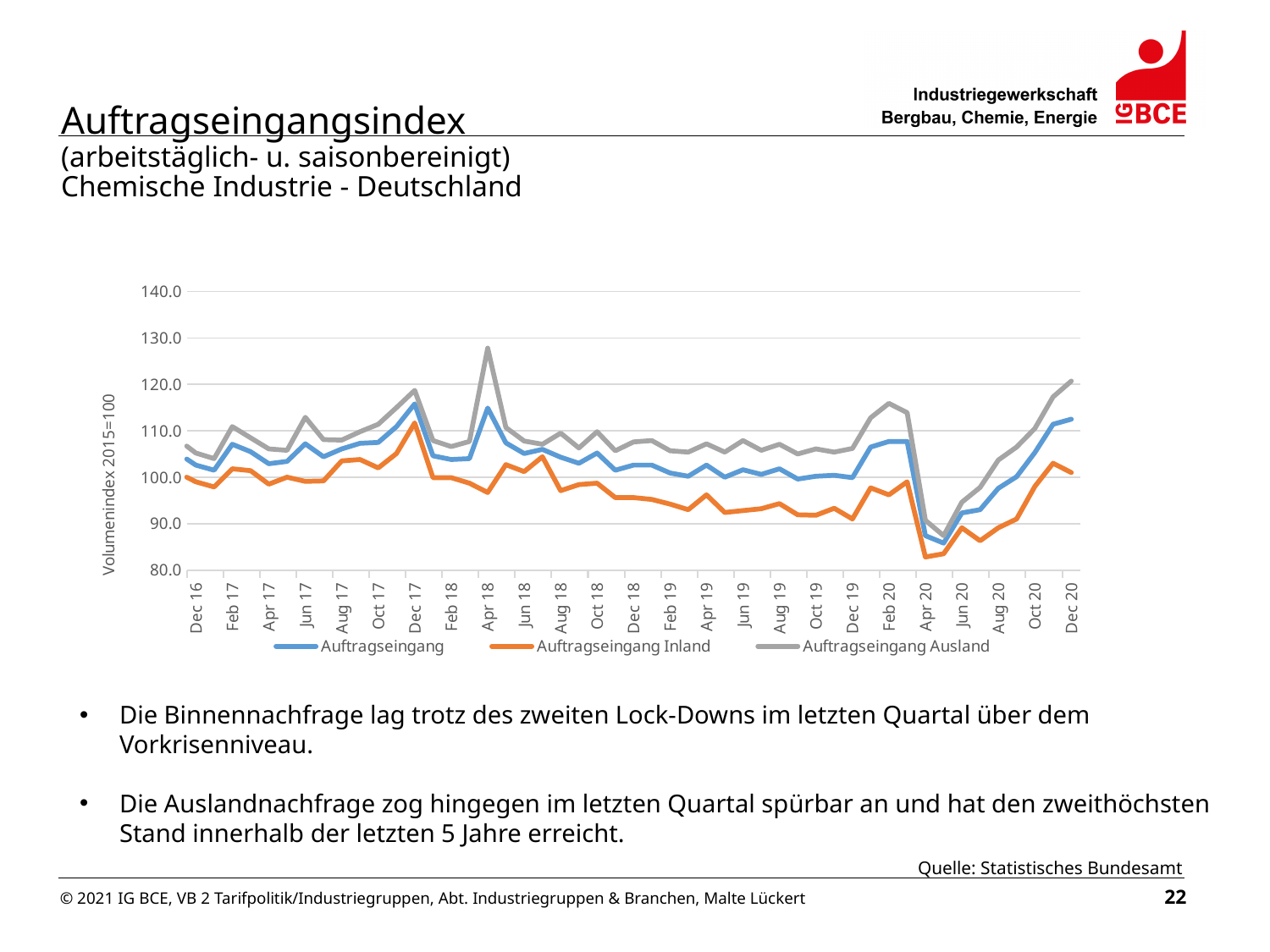
What kind of chart is shown on the slide? line chart Do the values for Auftragseingang Ausland rise or fall from Apr 20 to Dec 20? rise Is the value for Auftragseingang in Dec 20 greater or less than 110? greater How many series does the legend list? 3 What is the label of the y axis? Volumenindex 2015=100 In Dec 20, which is larger: Auftragseingang Ausland or Auftragseingang Inland? Auftragseingang Ausland Is the value for Auftragseingang Inland in Apr 20 greater or less than 90? less Which series is drawn in orange? Auftragseingang Inland Is the value for Auftragseingang Inland in Feb 19 greater or less than 100? less Which series reaches the highest value anywhere on the chart? Auftragseingang Ausland Which series has the lowest value in Apr 20? Auftragseingang Inland